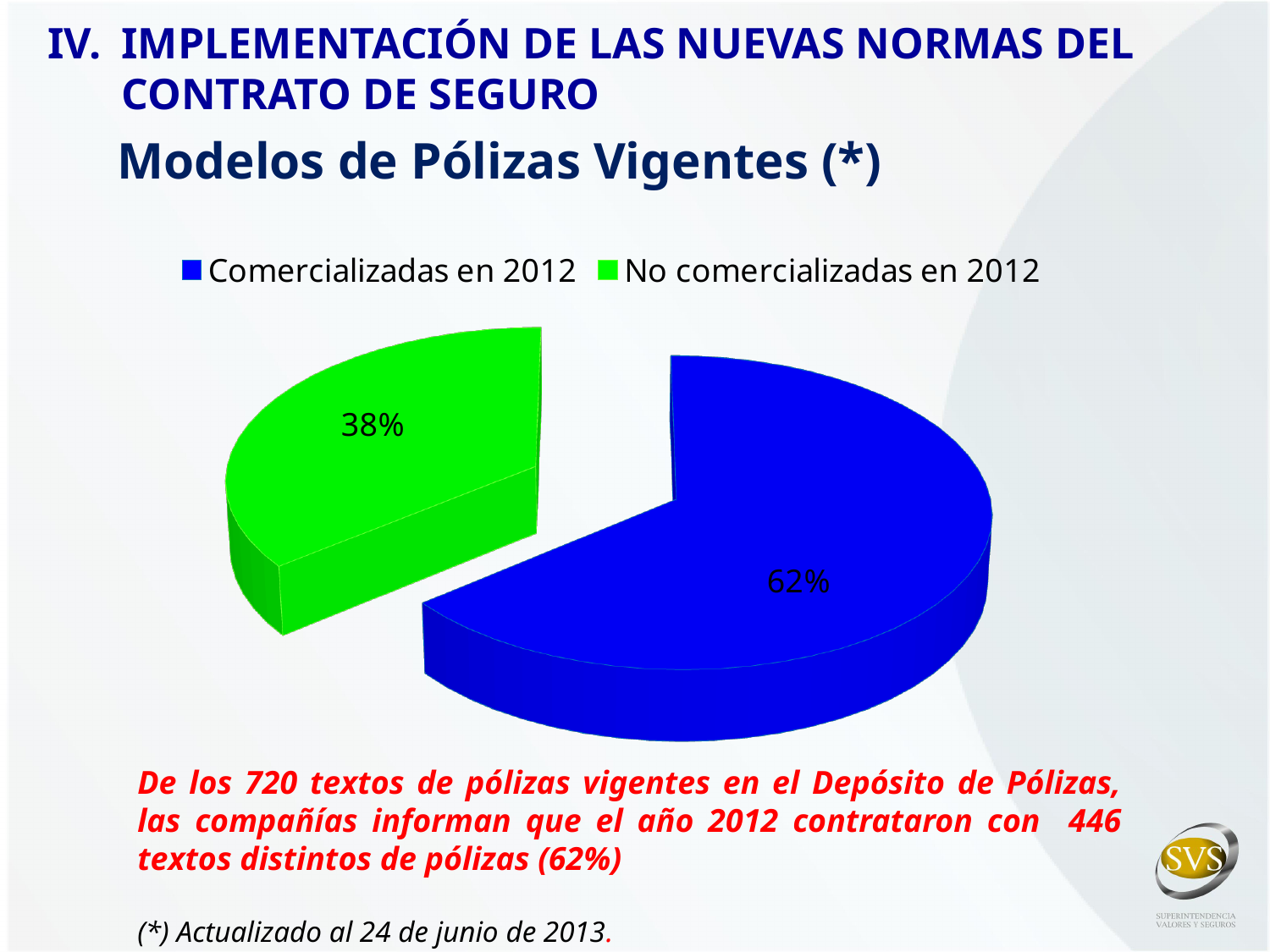
What colour is the slice for "No comercializadas en 2012"? green What kind of chart is shown on the slide? pie chart What percentage is shown for "No comercializadas en 2012"? 38% How many slices does the pie chart have? 2 Which is larger: "Comercializadas en 2012" or "No comercializadas en 2012"? Comercializadas en 2012 What is the difference in percentage points between "Comercializadas en 2012" and "No comercializadas en 2012"? 24 What is the title of the chart? Modelos de Pólizas Vigentes (*) Which slice of the pie is the largest? Comercializadas en 2012 What share of the pie does "No comercializadas en 2012" represent? 38% How many entries does the legend list? 2 Which slice of the pie is the smallest? No comercializadas en 2012 What percentage is shown for "Comercializadas en 2012"? 62%